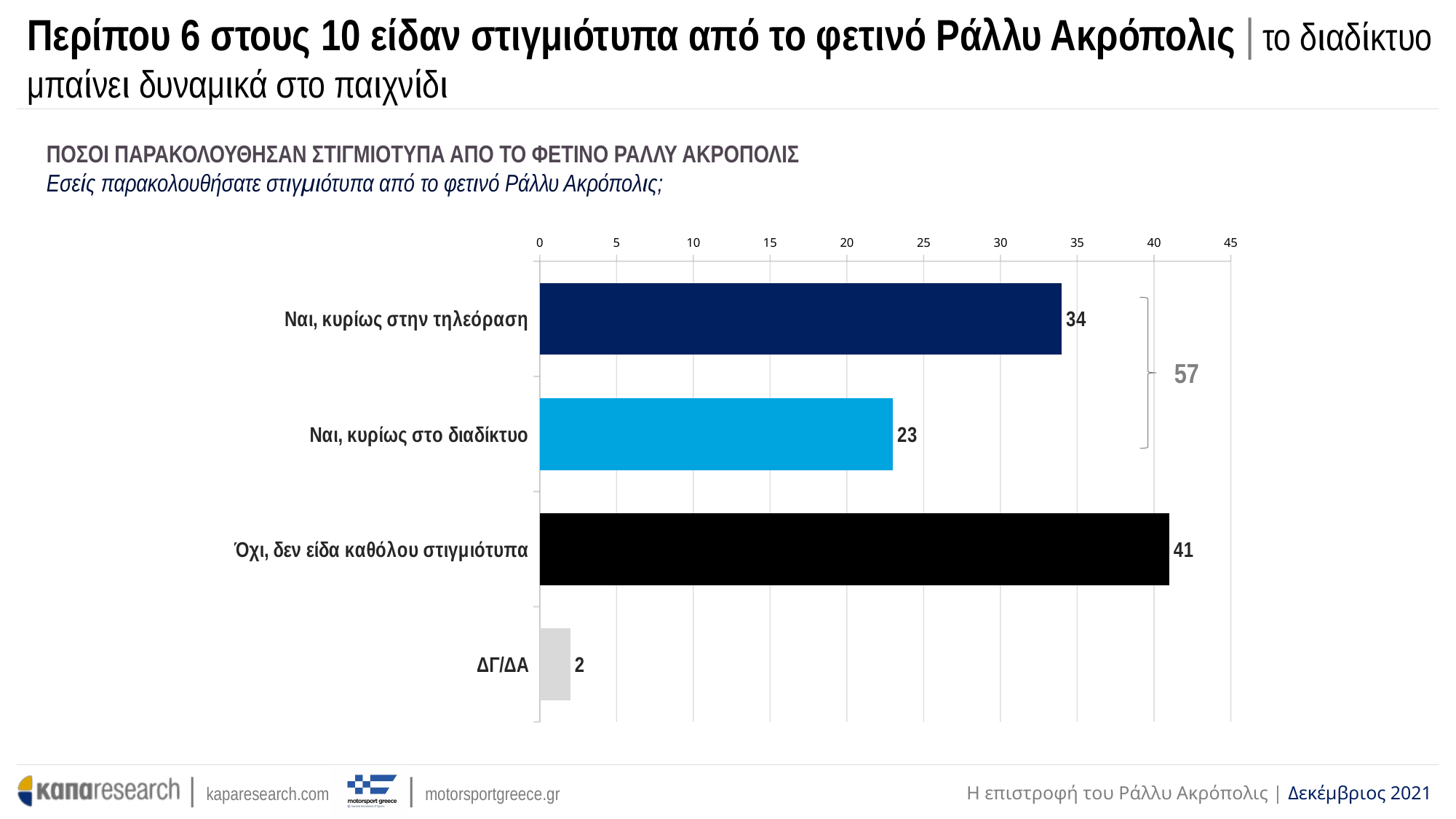
What is the value for 'Ναι, κυρίως στην τηλεόραση'? 34 What is the combined total shown by the bracket for the two 'Ναι' categories? 57 What is the value for 'Ναι, κυρίως στο διαδίκτυο'? 23 What is the value for 'ΔΓ/ΔΑ'? 2 Which category has the highest value? Όχι, δεν είδα καθόλου στιγμιότυπα What is the maximum value shown on the chart's axis? 45 What is the difference between the values for 'Όχι, δεν είδα καθόλου στιγμιότυπα' and 'Ναι, κυρίως στην τηλεόραση'? 7 Which category has the lowest value? ΔΓ/ΔΑ What is the value for 'Όχι, δεν είδα καθόλου στιγμιότυπα'? 41 Which is larger: the value for 'Ναι, κυρίως στην τηλεόραση' or 'Ναι, κυρίως στο διαδίκτυο'? Ναι, κυρίως στην τηλεόραση What kind of chart is shown on the slide? Bar chart How many categories are shown in the chart? 4